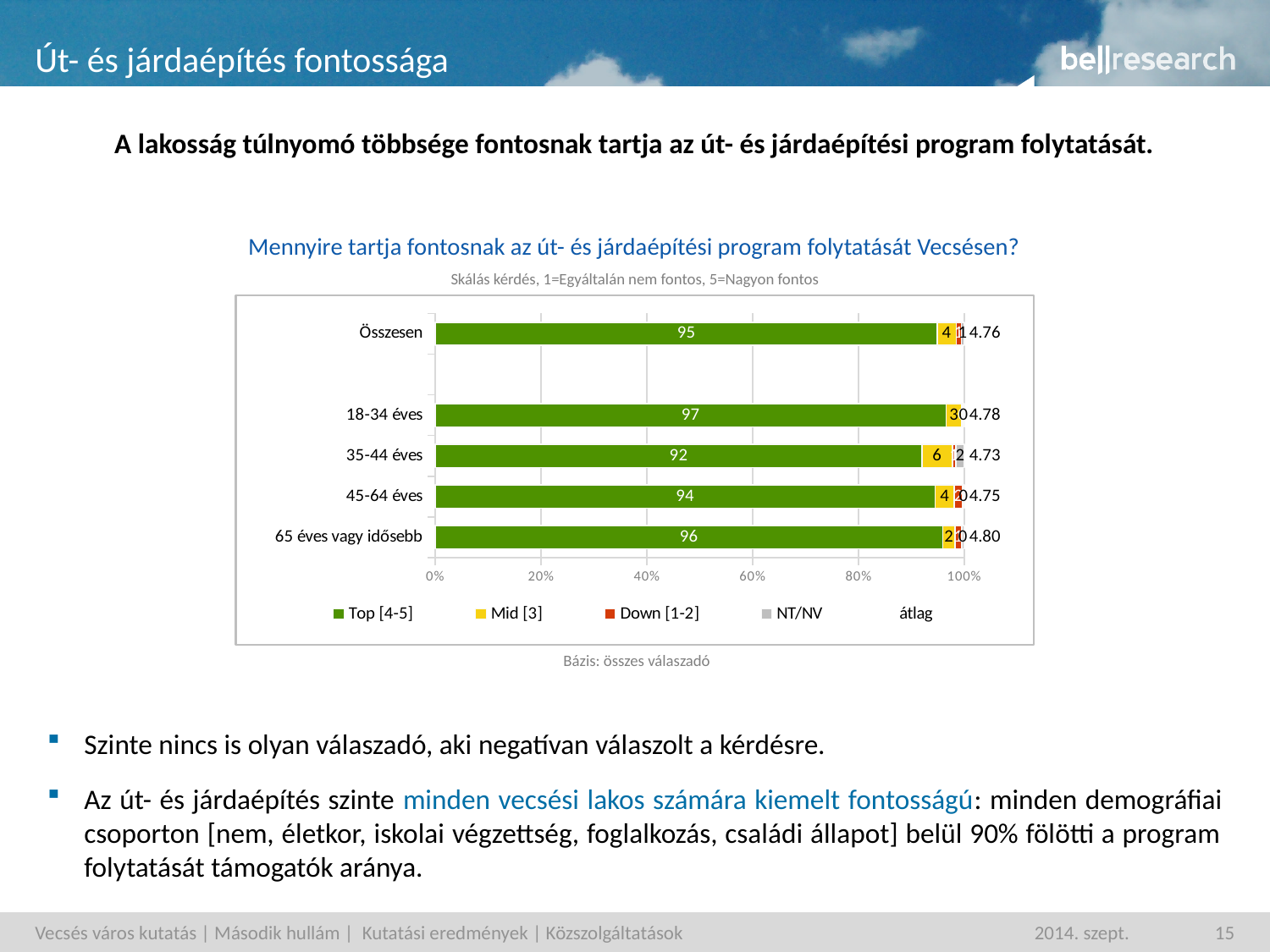
What is the Top [4-5] value for the 35-44 éves category? 92 What is the difference between the Top [4-5] values for 18-34 éves and 35-44 éves? 5 What type of chart is shown on the slide? Stacked bar chart Which category has the lowest Top [4-5] value? 35-44 éves Which category has the highest Top [4-5] value? 18-34 éves How many categories are shown on the vertical axis of the chart? 5 Which is larger, the Top [4-5] value for 45-64 éves or for 65 éves vagy idősebb? 65 éves vagy idősebb What is the Mid [3] value for the 35-44 éves category? 6 How many entries does the chart legend list? 5 What is the Mid [3] value for the Összesen category? 4 What is the átlag (average) shown for the 65 éves vagy idősebb category? 4.80 Which category has the highest átlag (average) value? 65 éves vagy idősebb